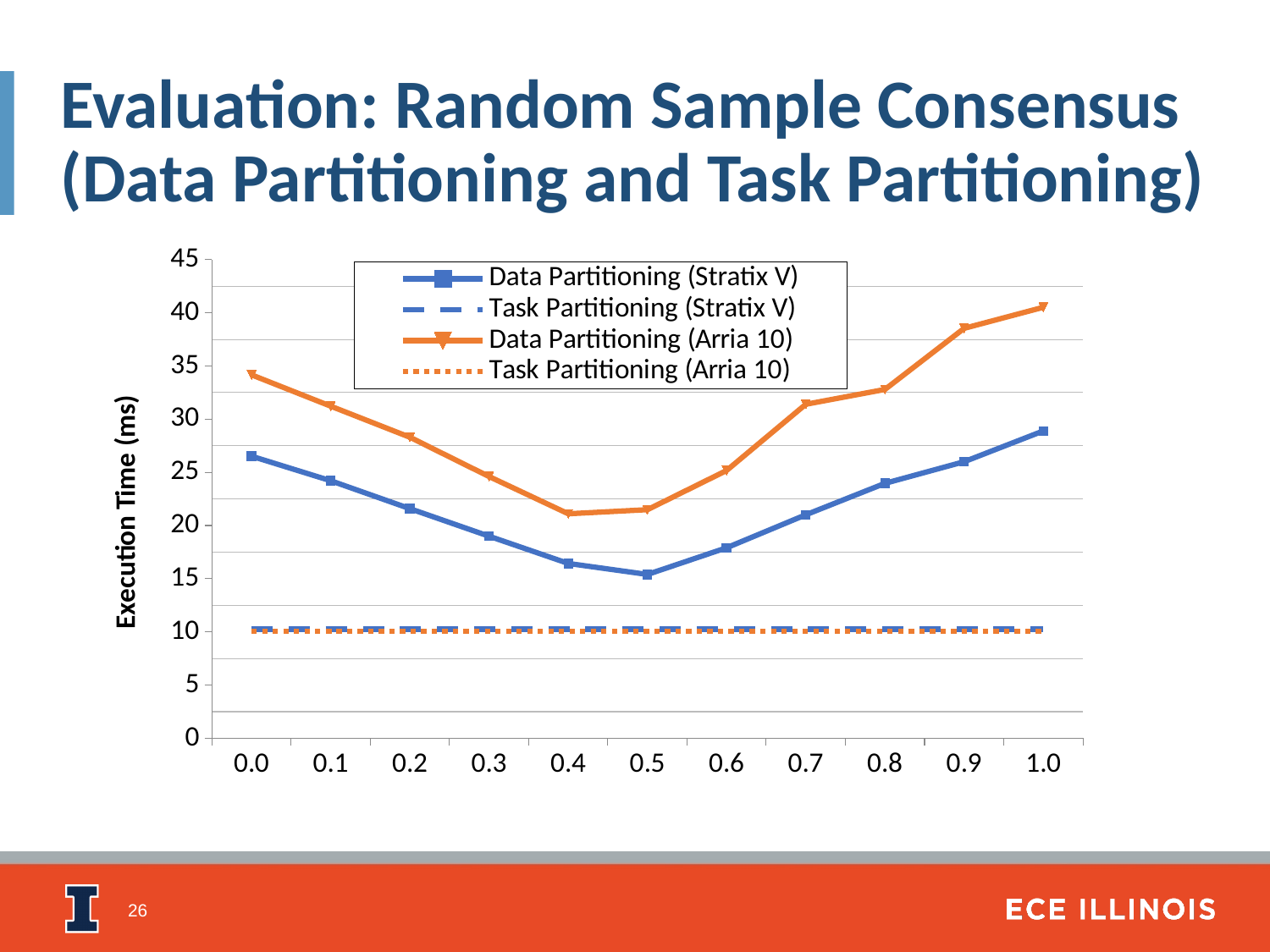
How many series does the legend list? 4 What kind of chart is shown on the slide? line chart Is the execution time for Data Partitioning (Arria 10) at x = 0.0 greater or less than 30? greater At which x value does the Data Partitioning (Stratix V) series reach its lowest execution time? 0.5 Is the execution time for Data Partitioning (Arria 10) at x = 0.4 greater or less than 25? less Is the execution time for Data Partitioning (Stratix V) at x = 1.0 greater or less than 30? less How many x-axis points are plotted for each series? 11 What is the label of the y axis? Execution Time (ms) Does the Data Partitioning (Stratix V) series rise or fall from x = 0.5 to x = 1.0? rise Which is larger at x = 0.7: Data Partitioning (Arria 10) or Data Partitioning (Stratix V)? Data Partitioning (Arria 10) Which series has the highest execution time at x = 1.0? Data Partitioning (Arria 10)